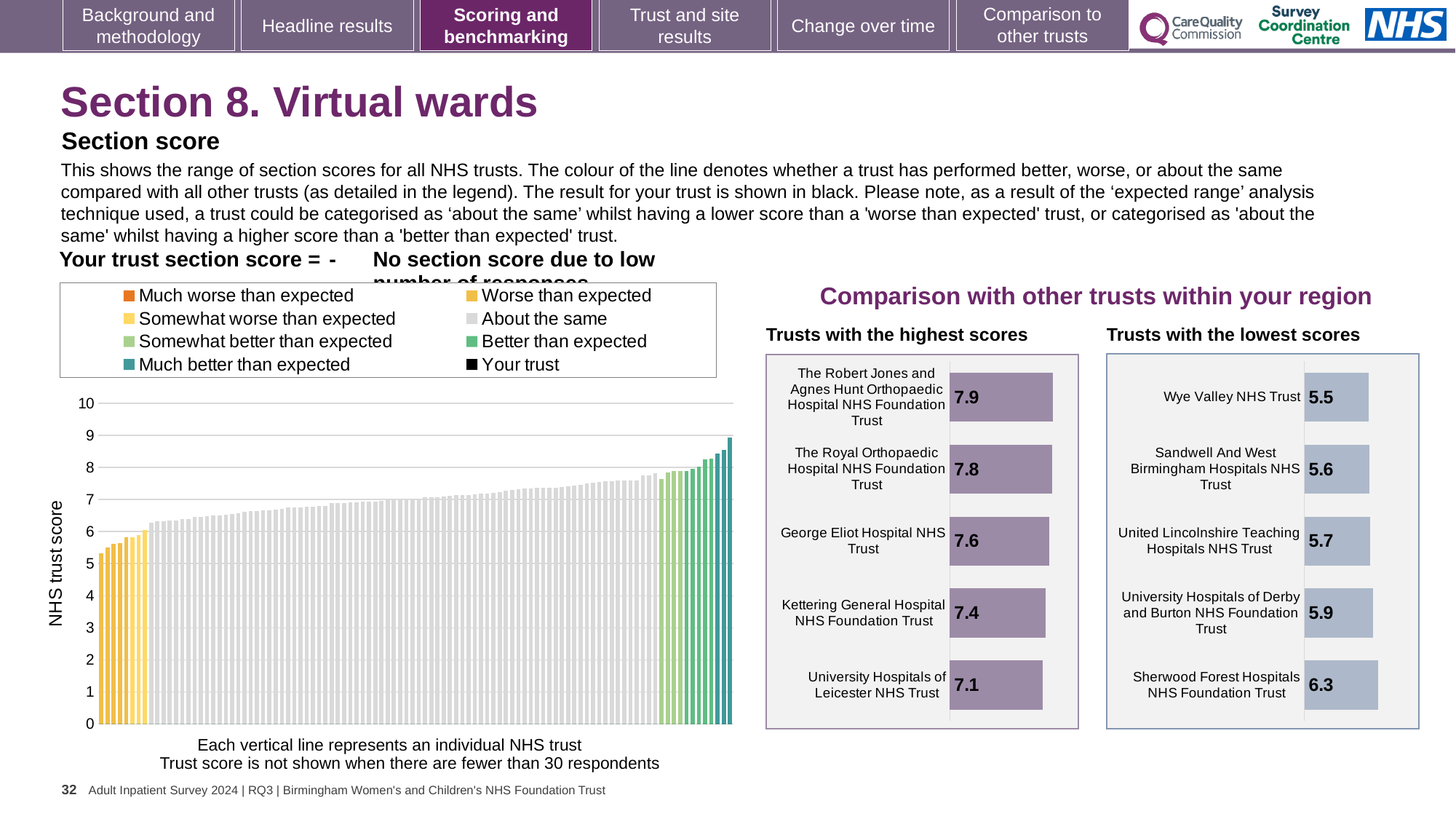
In the 'Trusts with the highest scores' chart, which trust has the highest score? The Robert Jones and Agnes Hunt Orthopaedic Hospital NHS Foundation Trust How many entries does the legend of the NHS trust score chart on the left list? 8 In the 'Trusts with the highest scores' chart, what is the difference between the scores of George Eliot Hospital NHS Trust and Kettering General Hospital NHS Foundation Trust? 0.2 In the NHS trust score chart on the left, is the value of the tallest bar greater or less than 8? greater In the 'Trusts with the highest scores' chart, what is the score for University Hospitals of Leicester NHS Trust? 7.1 In the 'Trusts with the lowest scores' chart, which trust has the lowest score? Wye Valley NHS Trust In the 'Trusts with the lowest scores' chart, what is the score for Wye Valley NHS Trust? 5.5 In the 'Trusts with the lowest scores' chart, which has the larger score: Sandwell And West Birmingham Hospitals NHS Trust or University Hospitals of Derby and Burton NHS Foundation Trust? University Hospitals of Derby and Burton NHS Foundation Trust In the 'Trusts with the highest scores' chart, what is the score for The Robert Jones and Agnes Hunt Orthopaedic Hospital NHS Foundation Trust? 7.9 In the 'Trusts with the lowest scores' chart, what is the score for Sherwood Forest Hospitals NHS Foundation Trust? 6.3 How many trusts are shown in the 'Trusts with the lowest scores' chart? 5 What kind of chart is the NHS trust score chart on the left of the slide? Bar chart